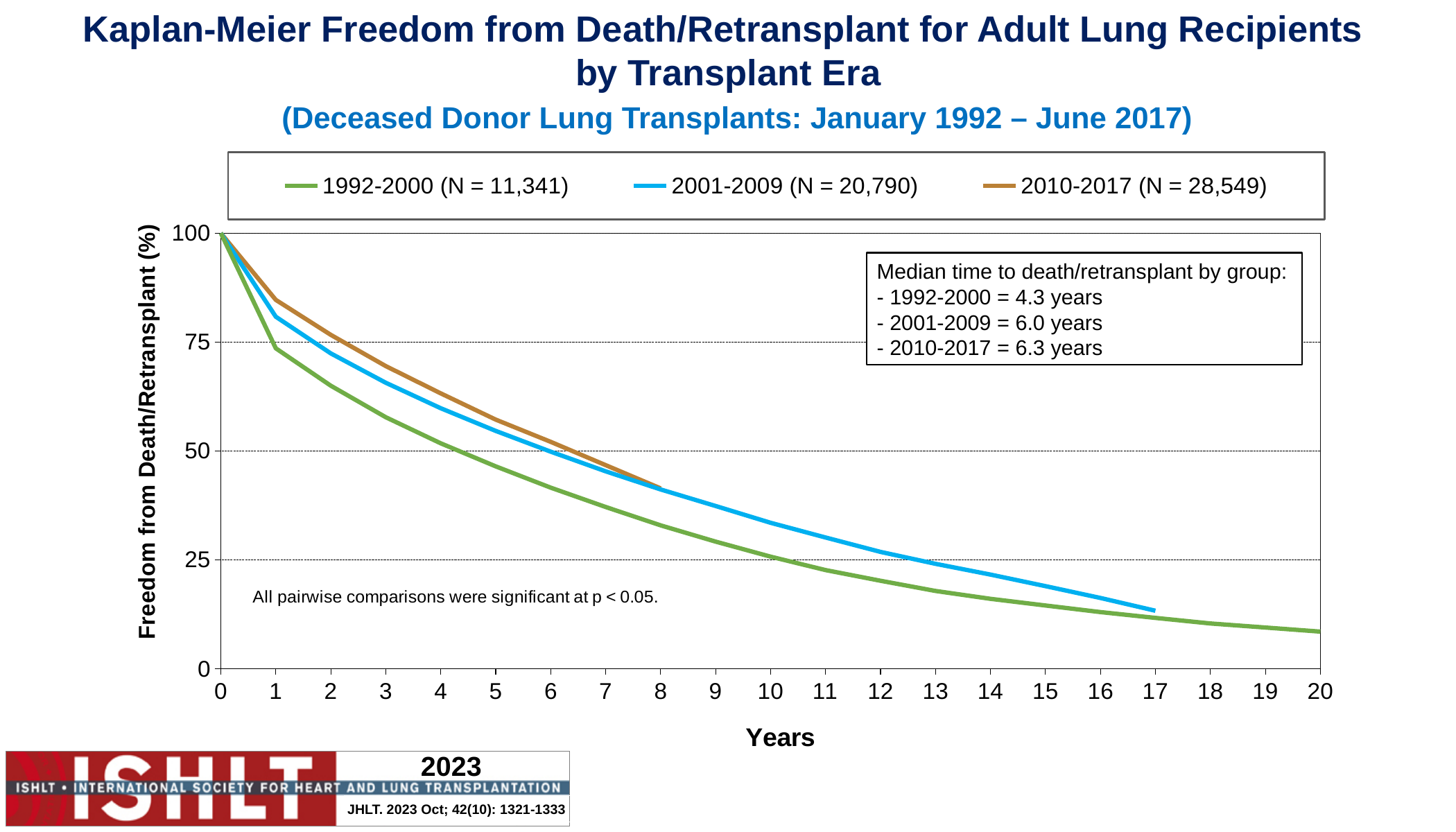
Do the curves rise or fall as the number of years increases? Fall At year 5, which group has the higher freedom from death/retransplant, 2010-2017 or 1992-2000? 2010-2017 Is the freedom from death/retransplant for the 2010-2017 group at year 1 greater or less than 75%? greater Which transplant era has the shortest median time to death/retransplant? 1992-2000 Is the freedom from death/retransplant for the 2001-2009 group at year 10 greater or less than 25%? greater What kind of chart is shown on the slide? Line chart Is the freedom from death/retransplant for the 1992-2000 group at year 1 greater or less than 75%? less What is the difference between the median time to death/retransplant for the 2010-2017 group and the 1992-2000 group? 2.0 years According to the text box, what is the median time to death/retransplant for the 1992-2000 group? 4.3 years Which transplant era has the longest median time to death/retransplant? 2010-2017 According to the text box, what is the median time to death/retransplant for the 2010-2017 group? 6.3 years How many series does the legend list? 3